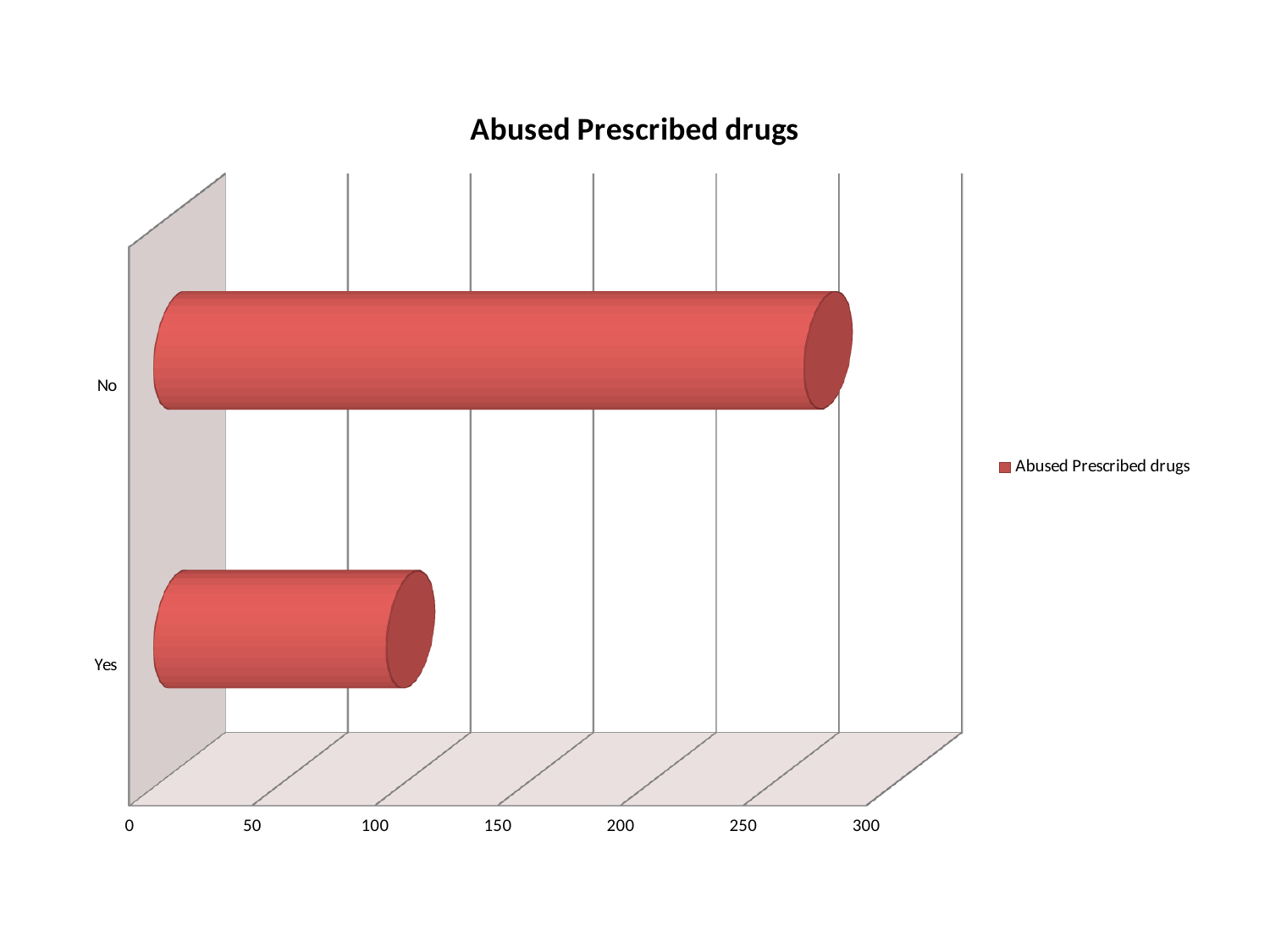
How many categories are shown on the chart? 2 What is the name of the series shown in the legend? Abused Prescribed drugs What is the title of the chart? Abused Prescribed drugs Is the value for No greater or less than 250? greater Which category has the lowest value? Yes How many series does the legend list? 1 Is the value for Yes greater or less than 50? greater What kind of chart is shown on the slide? bar chart Is the value for Yes greater or less than 150? less Which is larger, the value for No or the value for Yes? No Which category has the highest value? No